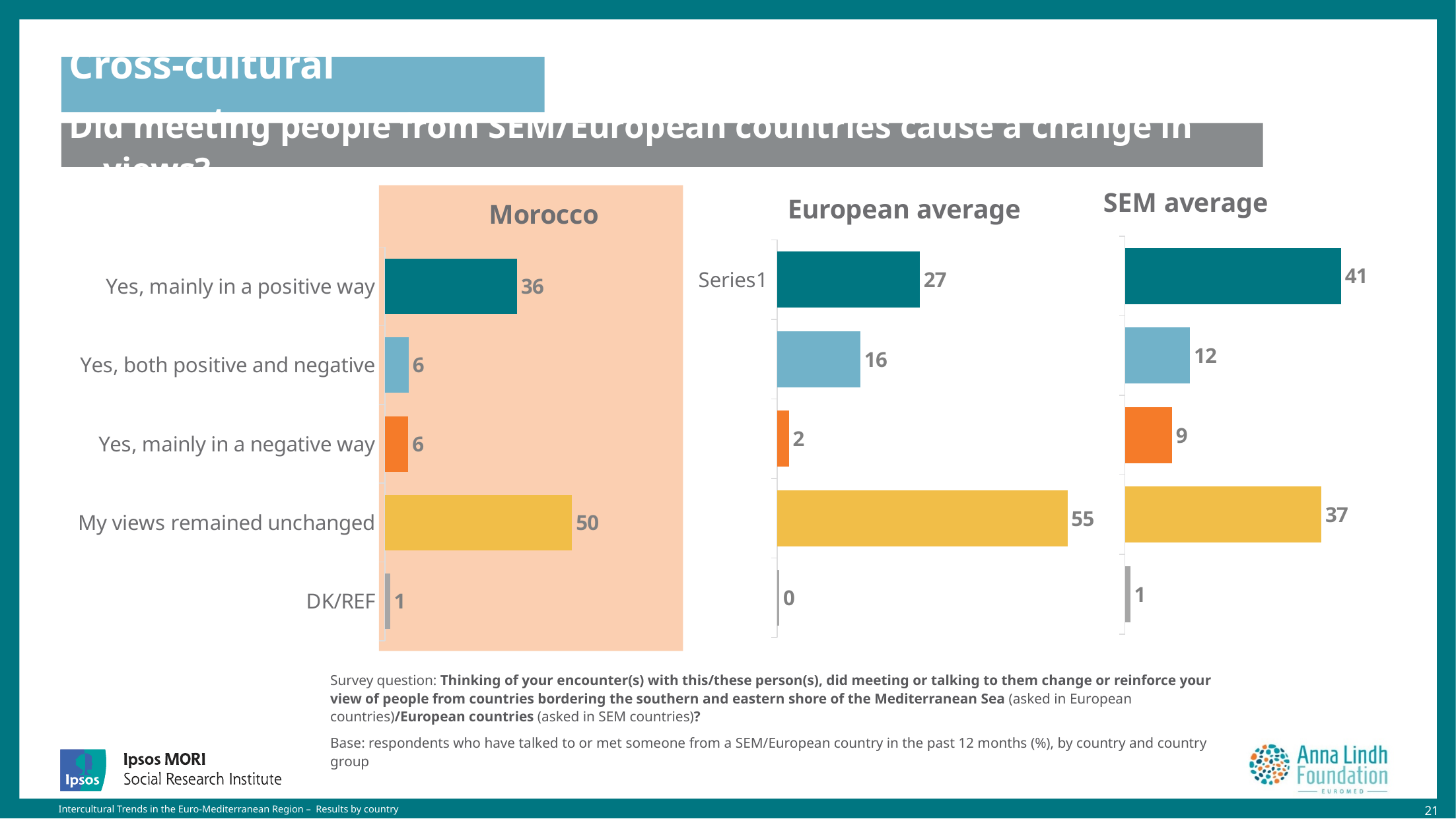
What colour is the bar for 'My views remained unchanged' in the Morocco chart? Yellow In the European average chart, which category has the lowest value? DK/REF Which is larger: 'Yes, mainly in a negative way' in the European average chart or in the SEM average chart? SEM average How many categories are shown in the Morocco chart? 5 In the SEM average chart, what is the difference between 'Yes, mainly in a positive way' and 'My views remained unchanged'? 4 In the SEM average chart, which category has the highest value? Yes, mainly in a positive way In the Morocco chart, what is the difference between 'My views remained unchanged' and 'Yes, mainly in a positive way'? 14 In the European average chart, what is the value for 'Yes, mainly in a positive way'? 27 What kind of chart is used for the Morocco data? Bar chart In the Morocco chart, which category has the highest value? My views remained unchanged In the Morocco chart, what is the value for 'My views remained unchanged'? 50 In the SEM average chart, what is the value for 'Yes, both positive and negative'? 12